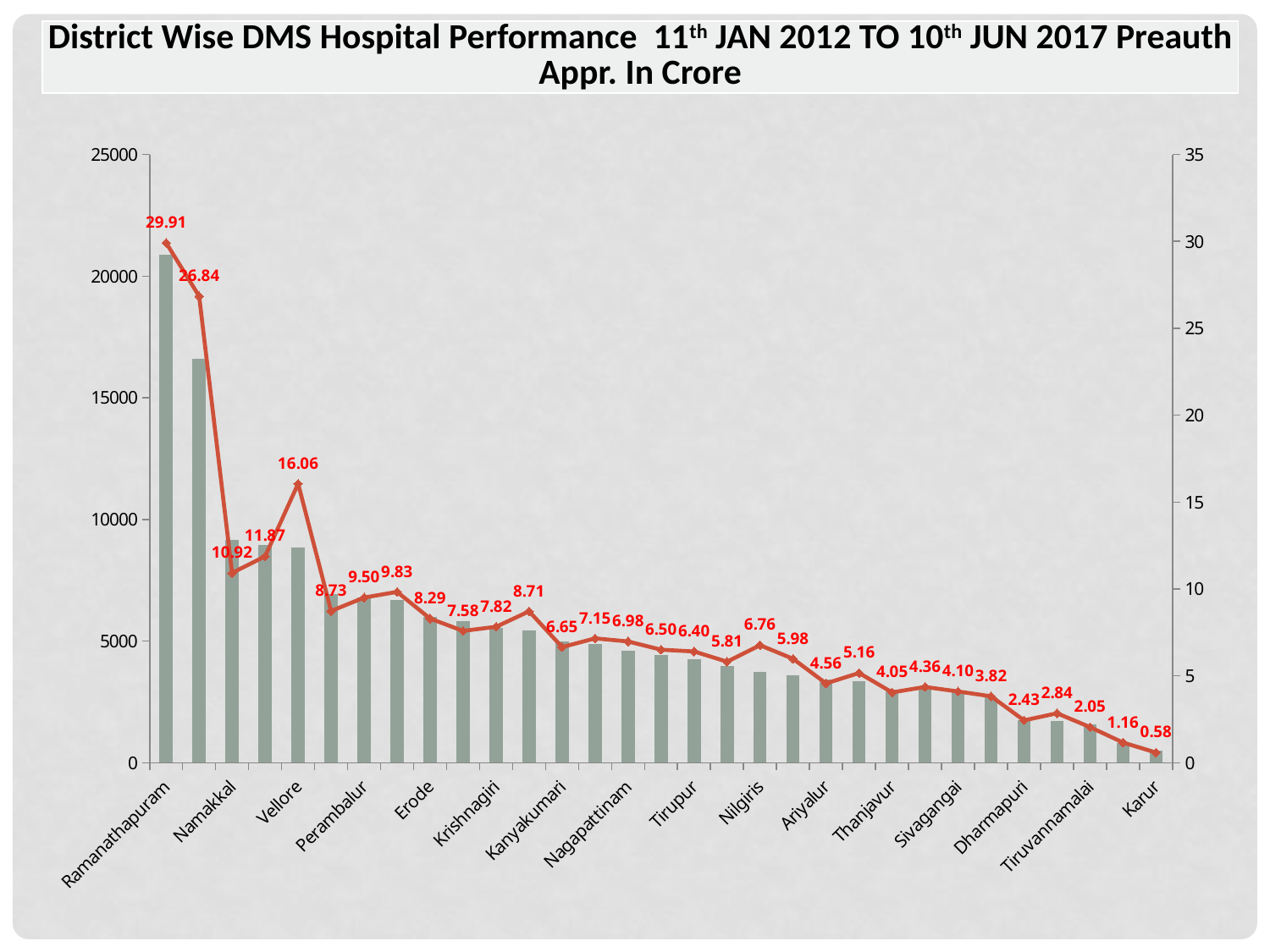
What value does the line show for Karur? 0.58 What is the difference between the line values for Vellore and Namakkal? 5.14 Which has the larger line value, Erode or Tirupur? Erode Which district has the highest value on the line? Ramanathapuram Do the line values generally rise or fall from left to right across the districts? Fall Is the bar value for Vellore greater or less than 10000? less Which district has the lowest value on the line? Karur Is the bar value for Ramanathapuram greater or less than 20000? greater What value does the line show for Namakkal? 10.92 What value does the line show for Vellore? 16.06 What kind of chart is shown on the slide? Combination bar and line chart What value does the line show for Ramanathapuram? 29.91